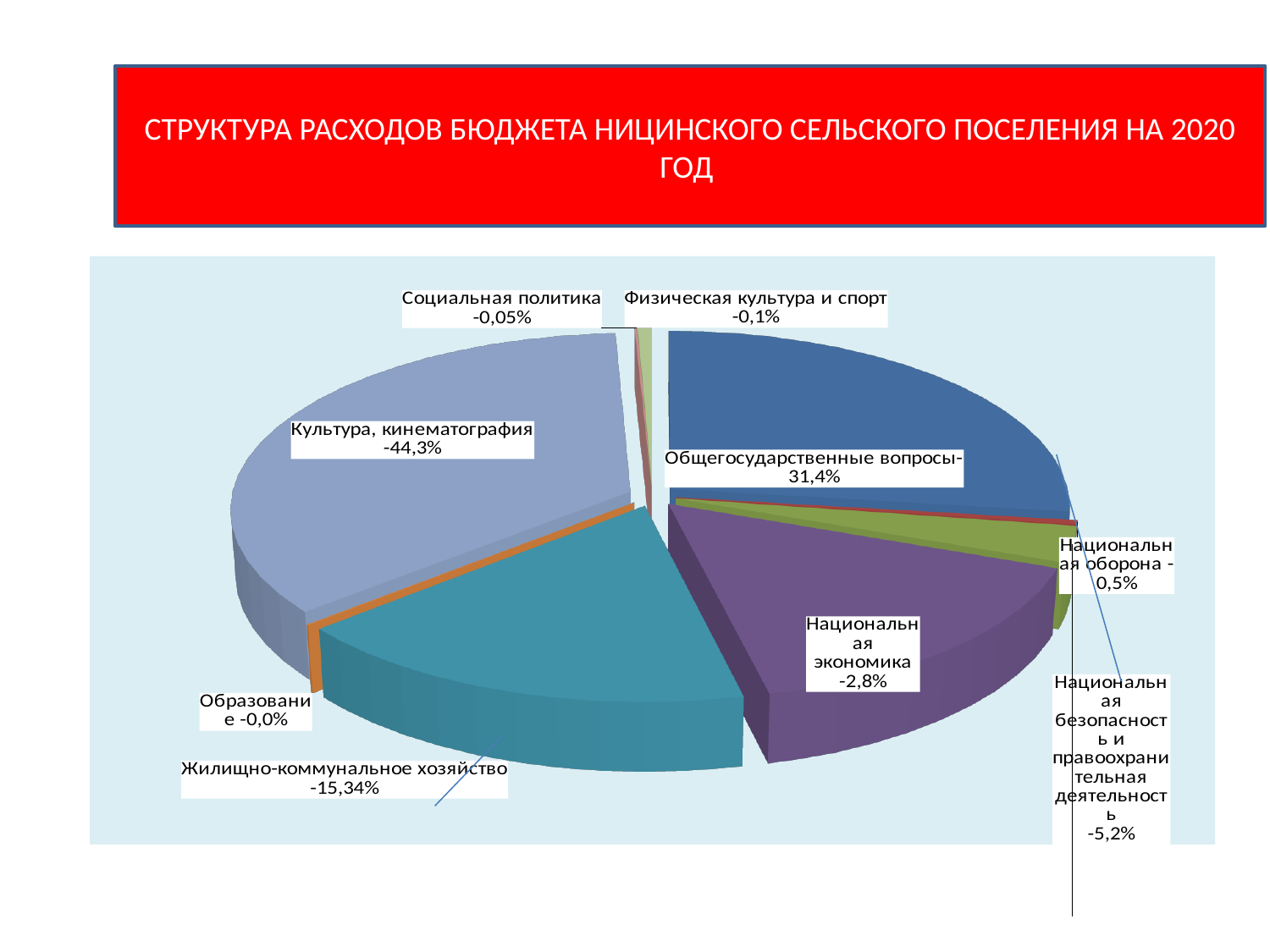
What is the share for Жилищно-коммунальное хозяйство? 15,34% What is the share for Национальная экономика? 2,8% What is the share for Национальная безопасность и правоохранительная деятельность? 5,2% What is the share for Культура, кинематография? 44,3% What is the share for Общегосударственные вопросы? 31,4% What kind of chart is shown on the slide? pie chart Which category has the smallest share of the pie? Образование What is the share for Национальная оборона? 0,5% Which category has the largest share of the pie? Культура, кинематография How many categories are shown in the pie chart? 9 What is the difference in percentage points between Культура, кинематография and Общегосударственные вопросы? 12,9